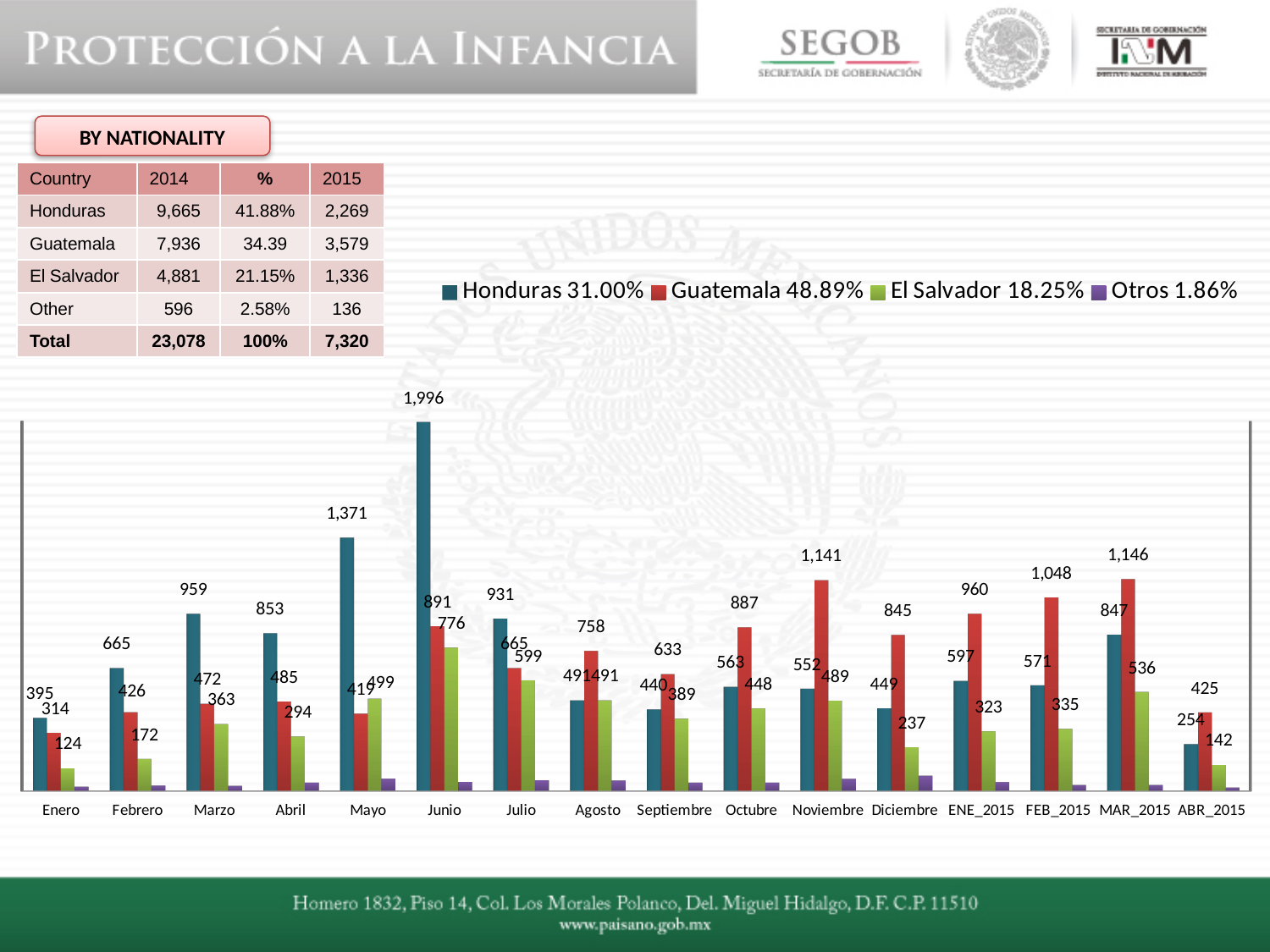
What percentage is shown next to Guatemala in the chart legend? 48.89% What is the value for Guatemala in MAR_2015? 1,146 How many month categories are shown along the x axis of the chart? 16 What is the difference between the Honduras value in Mayo and the Honduras value in Abril? 518 What is the value for El Salvador in Mayo? 499 In which month is the Honduras value highest? Junio Which is larger in Noviembre, the Honduras value or the Guatemala value? Guatemala What type of chart is shown on the slide? bar chart How many series does the chart legend list? 4 What colour are the bars for El Salvador in the chart? green In which month is the Guatemala value lowest? Enero What is the value for Honduras in Junio? 1,996